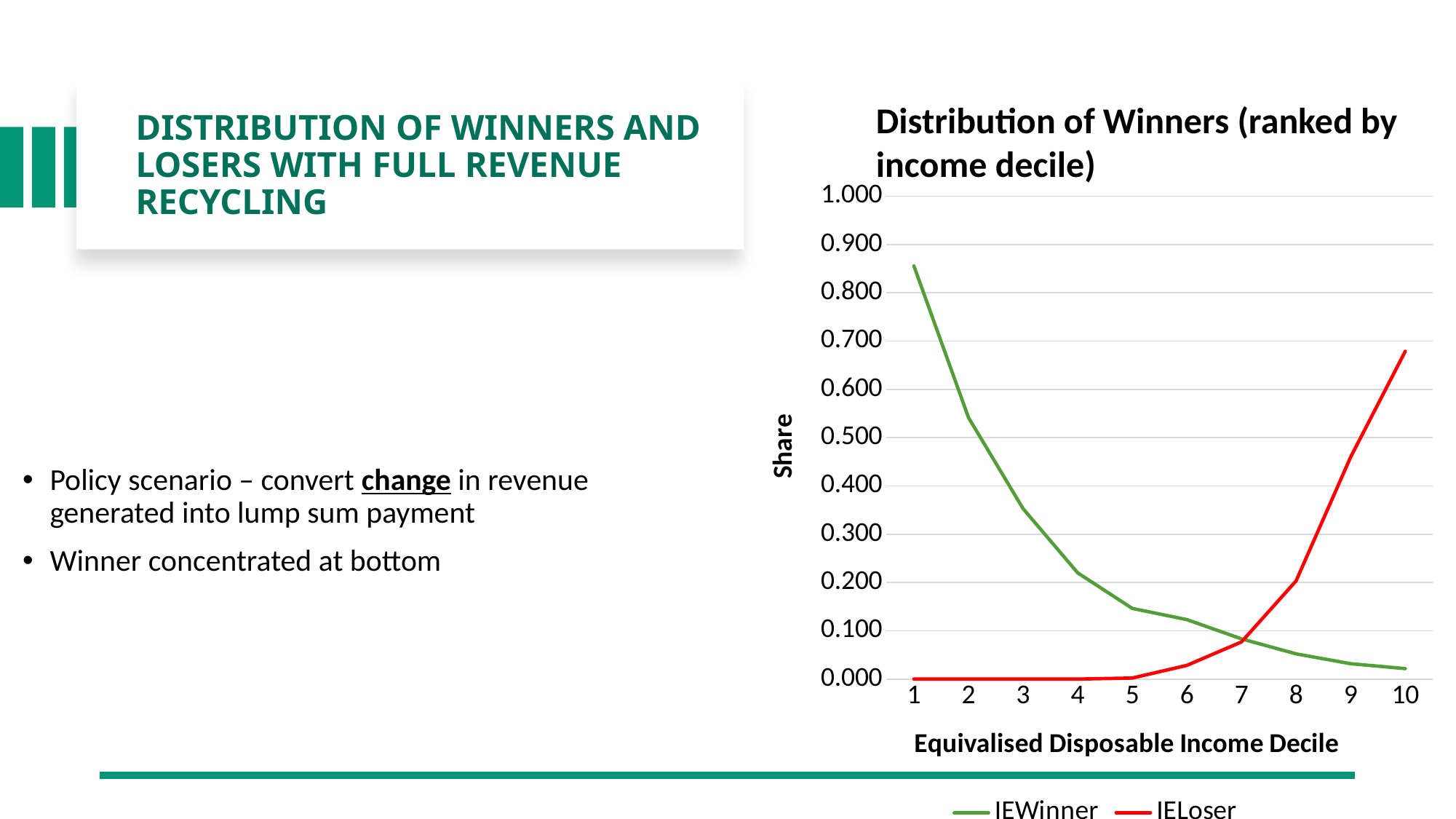
At which income decile is the IELoser share highest? 10 At decile 2, which series has the larger share, IEWinner or IELoser? IEWinner What kind of chart is shown on the slide? line chart How many series does the legend list? 2 Does the IELoser series rise or fall as the income decile increases? rises What is the title of the x axis? Equivalised Disposable Income Decile Is the IEWinner value for decile 3 greater or less than 0.400? less Is the IELoser value for decile 10 greater or less than 0.600? greater How many income deciles are plotted along the x axis? 10 Is the IEWinner value for decile 1 greater or less than 0.800? greater At which income decile is the IEWinner share highest? 1 Does the IEWinner series rise or fall as the income decile increases? falls